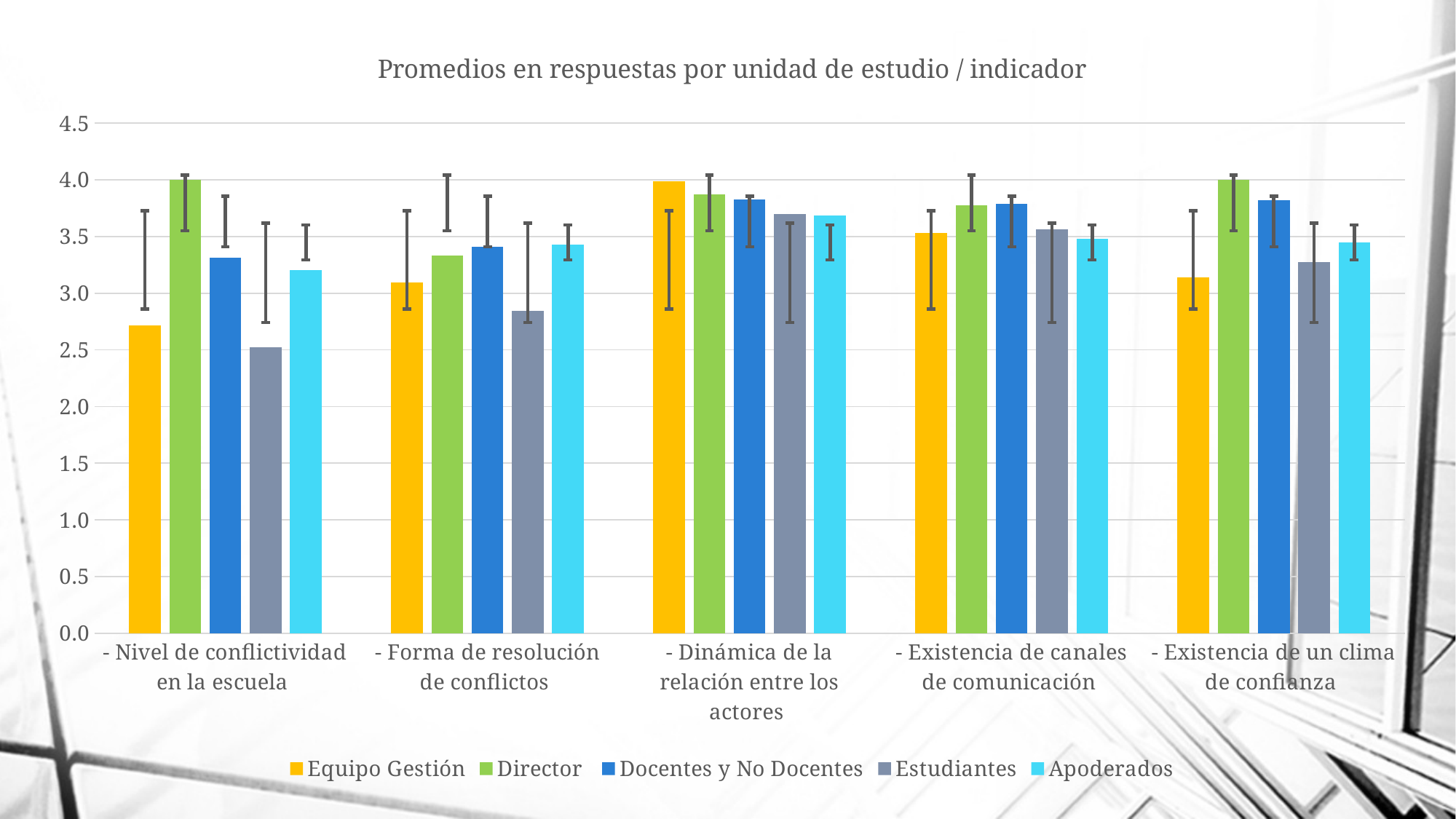
What kind of chart is shown on the slide? bar chart Which series is shown in orange in the legend? Equipo Gestión What is the title of the chart? Promedios en respuestas por unidad de estudio / indicador For '- Nivel de conflictividad en la escuela', which is larger: the value for Director or the value for Equipo Gestión? Director Is the value for Equipo Gestión in '- Dinámica de la relación entre los actores' greater or less than 3.5? greater Which series has the highest value for '- Nivel de conflictividad en la escuela'? Director Which series has the lowest value for '- Nivel de conflictividad en la escuela'? Estudiantes Which series has the lowest value for '- Forma de resolución de conflictos'? Estudiantes Is the value for Equipo Gestión in '- Nivel de conflictividad en la escuela' greater or less than 3.0? less How many series does the legend list? 5 How many categories are shown on the x axis? 5 Which series has the highest value for '- Existencia de un clima de confianza'? Director